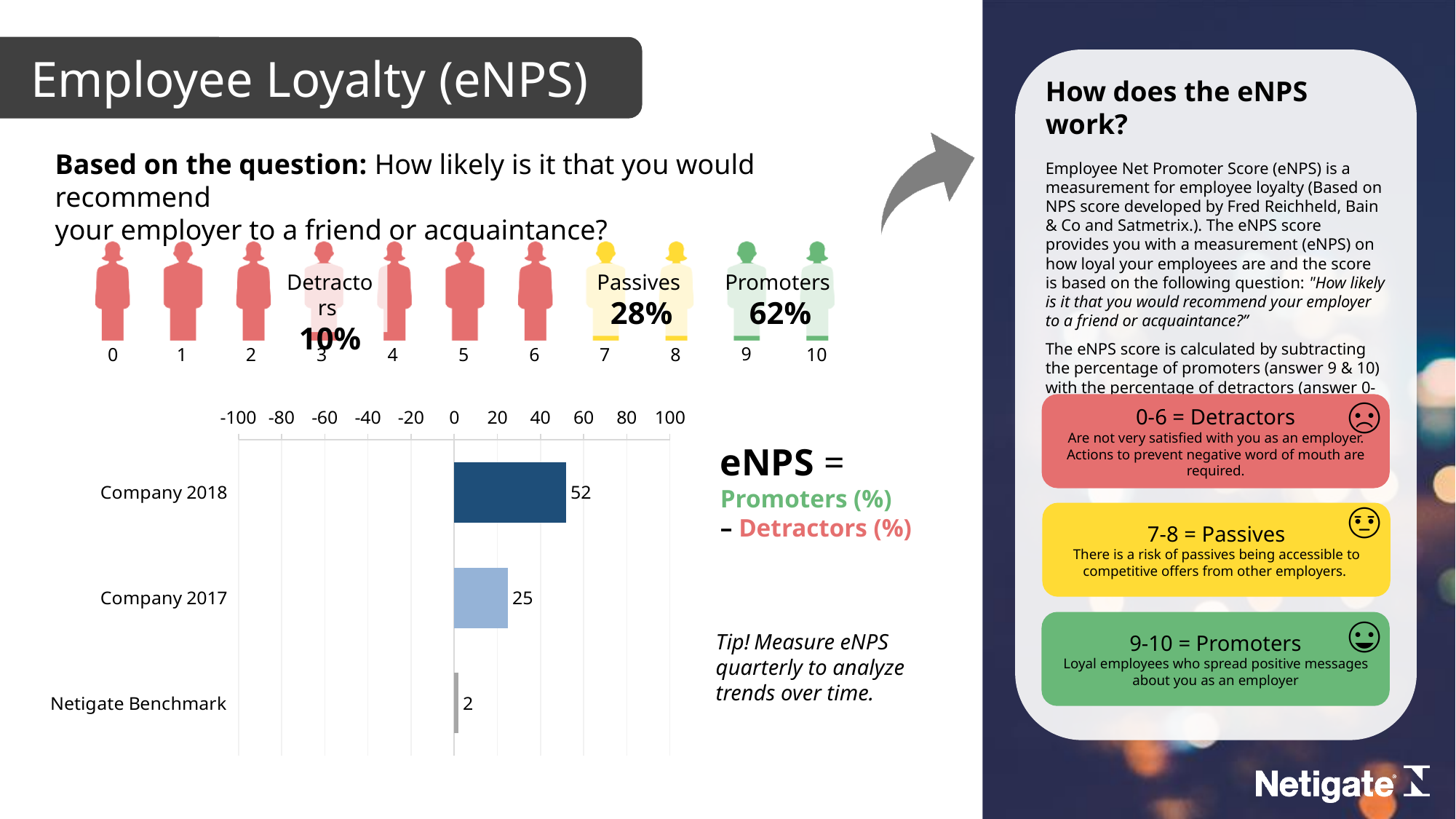
What is the difference between the Company 2018 and Company 2017 values in the bar chart? 27 What is the eNPS value shown for Company 2017 in the bar chart? 25 Which category in the bar chart has the highest value? Company 2018 Is the value for Company 2018 in the bar chart greater or less than 40? greater What is the value shown for Netigate Benchmark in the bar chart? 2 Which category in the bar chart has the lowest value? Netigate Benchmark What is the difference between the Company 2017 value and the Netigate Benchmark value in the bar chart? 23 What is the lowest value shown on the horizontal axis of the bar chart? -100 Which is larger in the bar chart, the value for Company 2017 or the value for Netigate Benchmark? Company 2017 What is the eNPS value shown for Company 2018 in the bar chart? 52 How many categories are plotted in the bar chart? 3 What kind of chart is used to show the eNPS values for Company 2018, Company 2017 and Netigate Benchmark? Bar chart